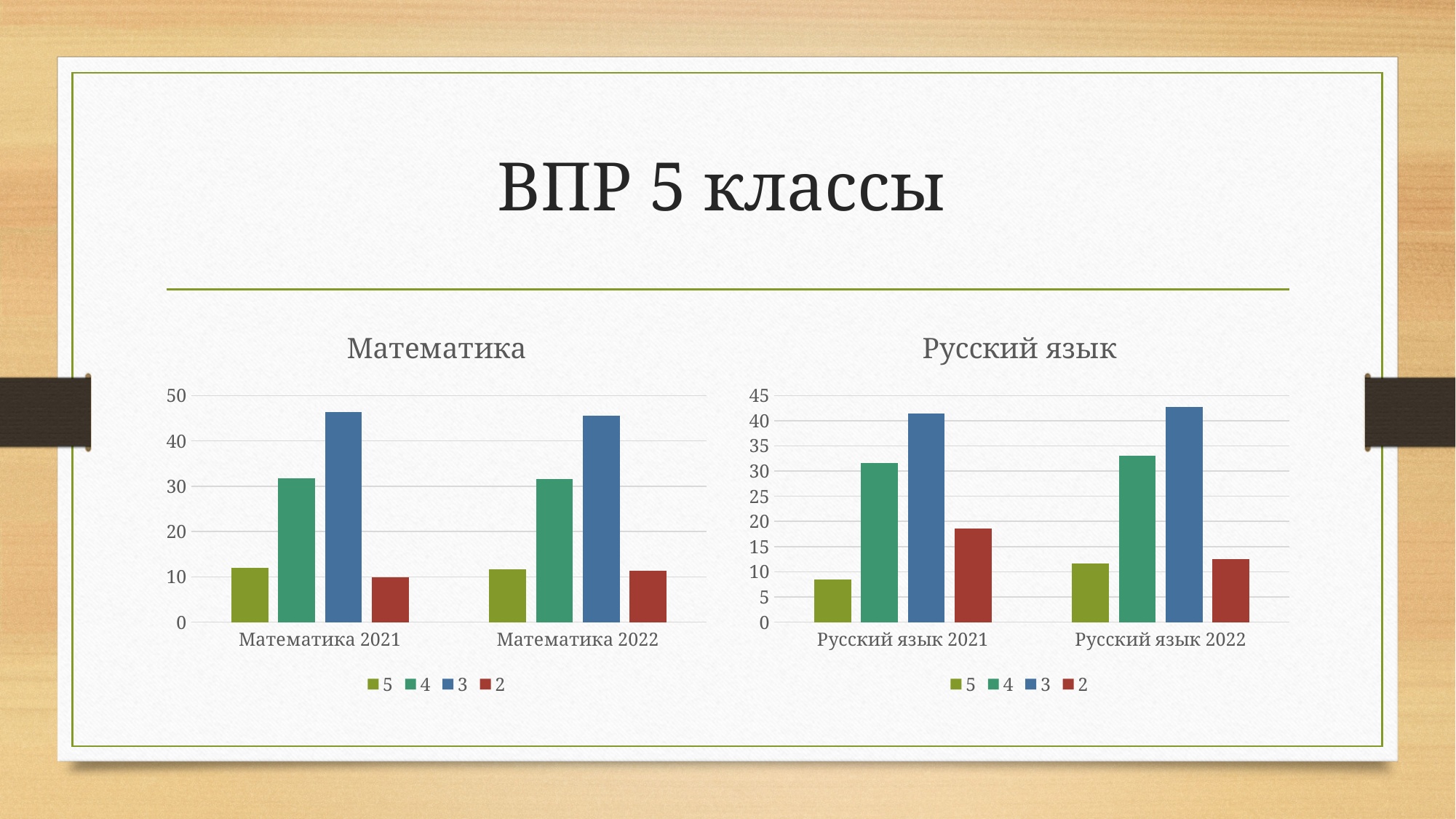
What is the title of the chart on the right side of the slide? Русский язык In the Русский язык chart, which is larger: series 5 in Русский язык 2021 or series 5 in Русский язык 2022? Русский язык 2022 What kind of chart is the Математика chart? bar chart How many categories are shown on the x axis of the Математика chart? 2 In the Математика chart, is the value for series 3 in Математика 2021 greater or less than 40? greater How many series does the legend of the Русский язык chart list? 4 In the Математика chart, is the value for series 2 in Математика 2021 greater or less than 20? less In the Русский язык chart, is the value for series 5 in Русский язык 2021 greater or less than 10? less In the Математика chart, which series has the highest bar for Математика 2021? 3 In the Русский язык chart, which is larger: series 2 in Русский язык 2021 or series 2 in Русский язык 2022? Русский язык 2021 In the Русский язык chart, which series has the lowest bar for Русский язык 2021? 5